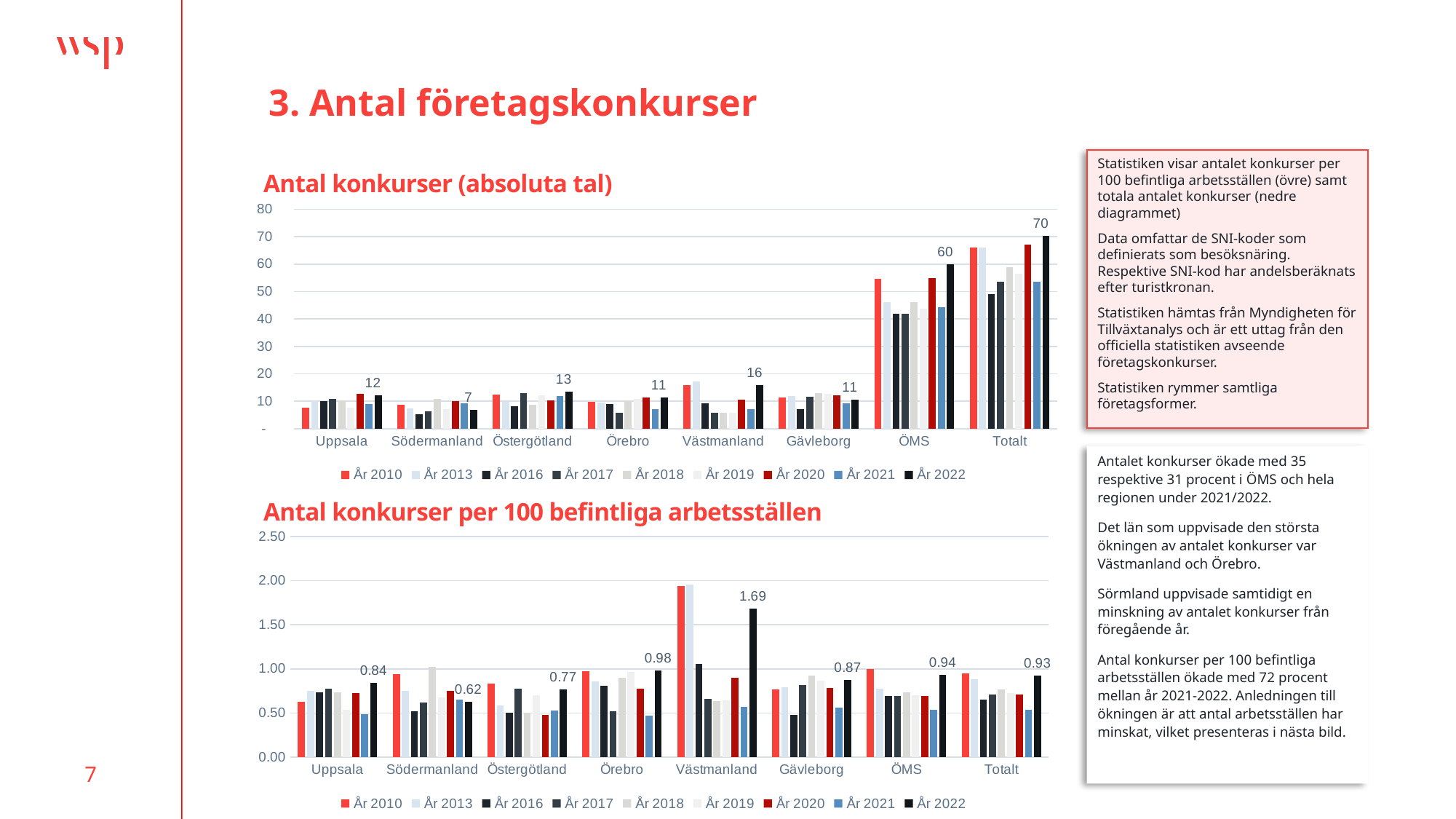
In the chart 'Antal konkurser per 100 befintliga arbetsställen', what is the value for Södermanland in År 2022? 0.62 How many series does the legend of the chart 'Antal konkurser (absoluta tal)' list? 9 In the chart 'Antal konkurser (absoluta tal)', what is the difference between the År 2022 values for Totalt and ÖMS? 10 In the chart 'Antal konkurser (absoluta tal)', which county (excluding ÖMS and Totalt) has the lowest År 2022 value? Södermanland In the chart 'Antal konkurser per 100 befintliga arbetsställen', what is the value for Västmanland in År 2022? 1.69 In the chart 'Antal konkurser (absoluta tal)', what is the value for ÖMS in År 2022? 60 In the chart 'Antal konkurser (absoluta tal)', what is the value for Totalt in År 2022? 70 What kind of chart is 'Antal konkurser per 100 befintliga arbetsställen'? Bar chart In the chart 'Antal konkurser (absoluta tal)', what is the value for Västmanland in År 2022? 16 In the chart 'Antal konkurser per 100 befintliga arbetsställen', is the År 2010 value for Västmanland greater or less than 1.50? greater In the chart 'Antal konkurser (absoluta tal)', is the År 2022 value for Uppsala greater or less than the År 2022 value for Östergötland? less In the chart 'Antal konkurser per 100 befintliga arbetsställen', which category has the highest År 2022 value? Västmanland